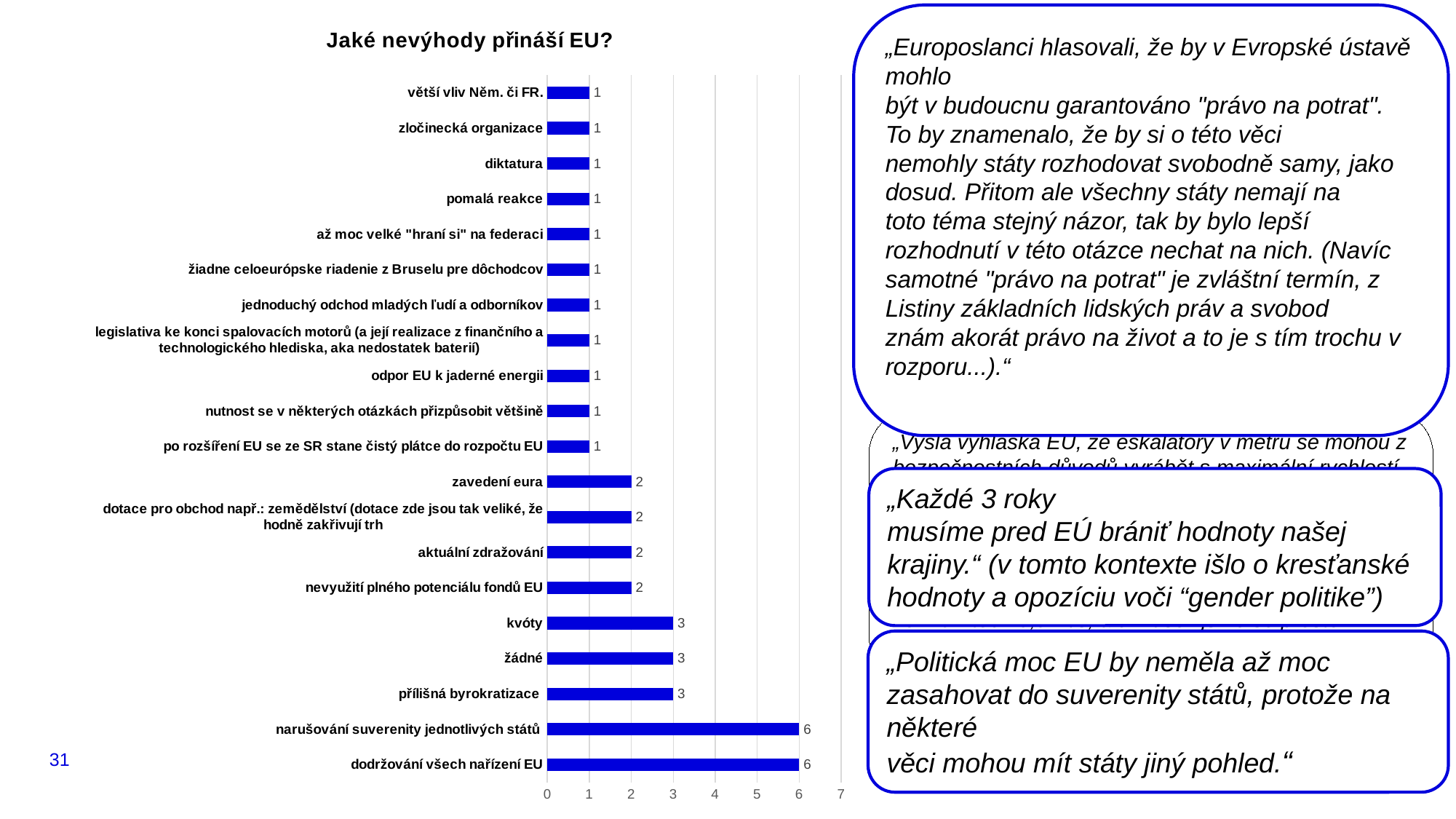
Is the value for "dodržování všech nařízení EU" greater or less than 5? greater What is the title of the chart? Jaké nevýhody přináší EU? What is the difference between the values for "dodržování všech nařízení EU" and "přílišná byrokratizace"? 3 What is the value for "zavedení eura"? 2 What is the highest value shown in the chart? 6 What is the value for "diktatura"? 1 What is the lowest value shown in the chart? 1 How many categories are shown in the chart? 20 What is the value for "kvóty"? 3 What kind of chart is shown on the slide? bar chart What is the value for "narušování suverenity jednotlivých států"? 6 Which has a larger value, "žádné" or "aktuální zdražování"? žádné